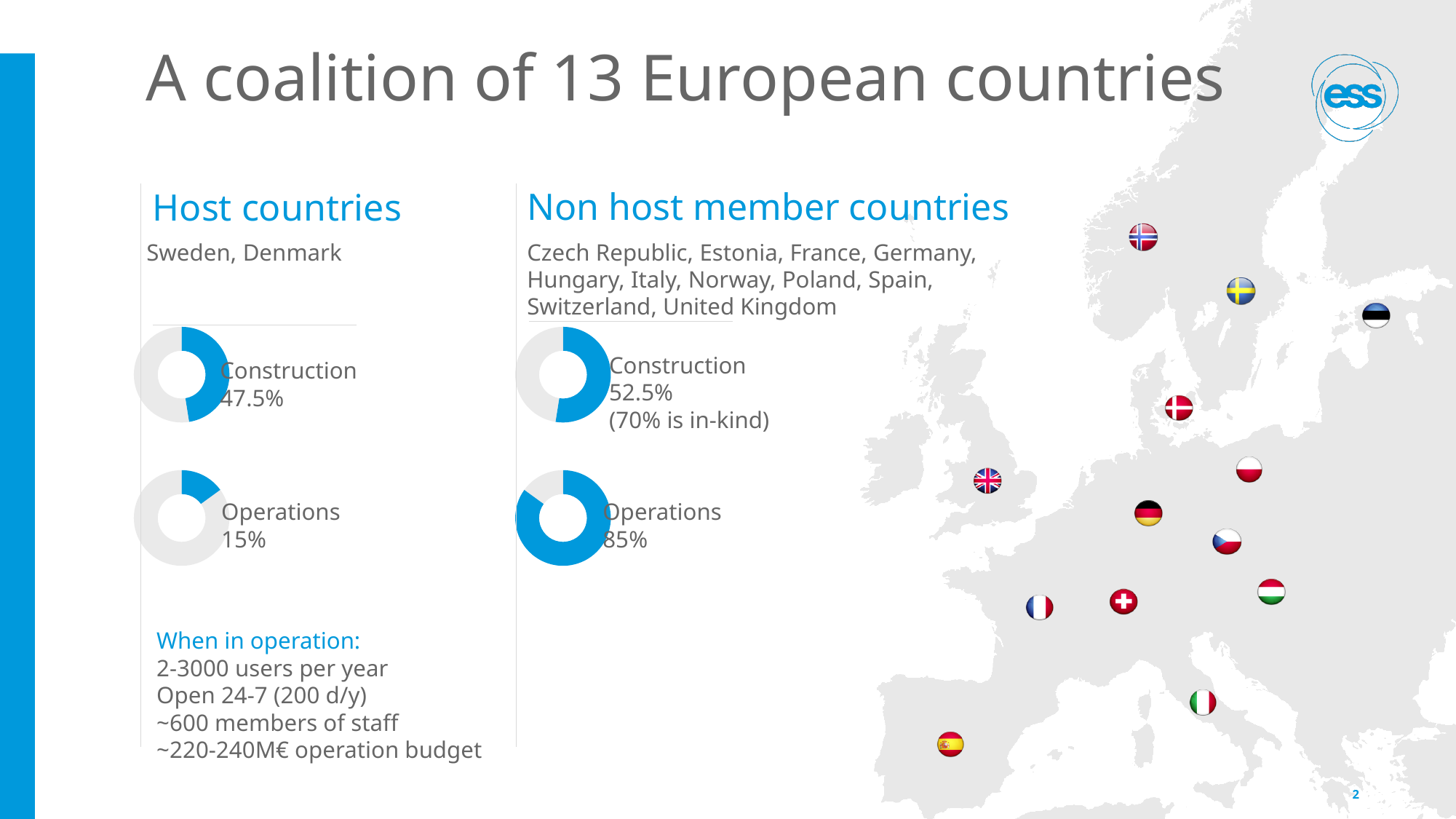
In the Host countries Construction donut chart, what share is shown? 47.5% What is the total of the Host countries Construction share and the Non host member countries Construction share? 100% In the Host countries Operations donut chart, what share is shown? 15% What is the difference between the Non host member countries Construction share and the Host countries Construction share? 5 percentage points What is the difference between the Non host member countries Operations share and the Host countries Operations share? 70 percentage points What kind of charts are used to show the Construction and Operations shares on the slide? Donut (pie) charts Which is larger: the Host countries Construction share or the Non host member countries Construction share? Non host member countries Construction (52.5%) According to the note next to the Non host member countries Construction chart, what percentage is in-kind? 70% How many donut charts are shown on the slide? 4 In the Non host member countries Construction donut chart, what share is shown? 52.5% In the Non host member countries Operations donut chart, what share is shown? 85% Which is larger: the Host countries Operations share or the Non host member countries Operations share? Non host member countries Operations (85%)